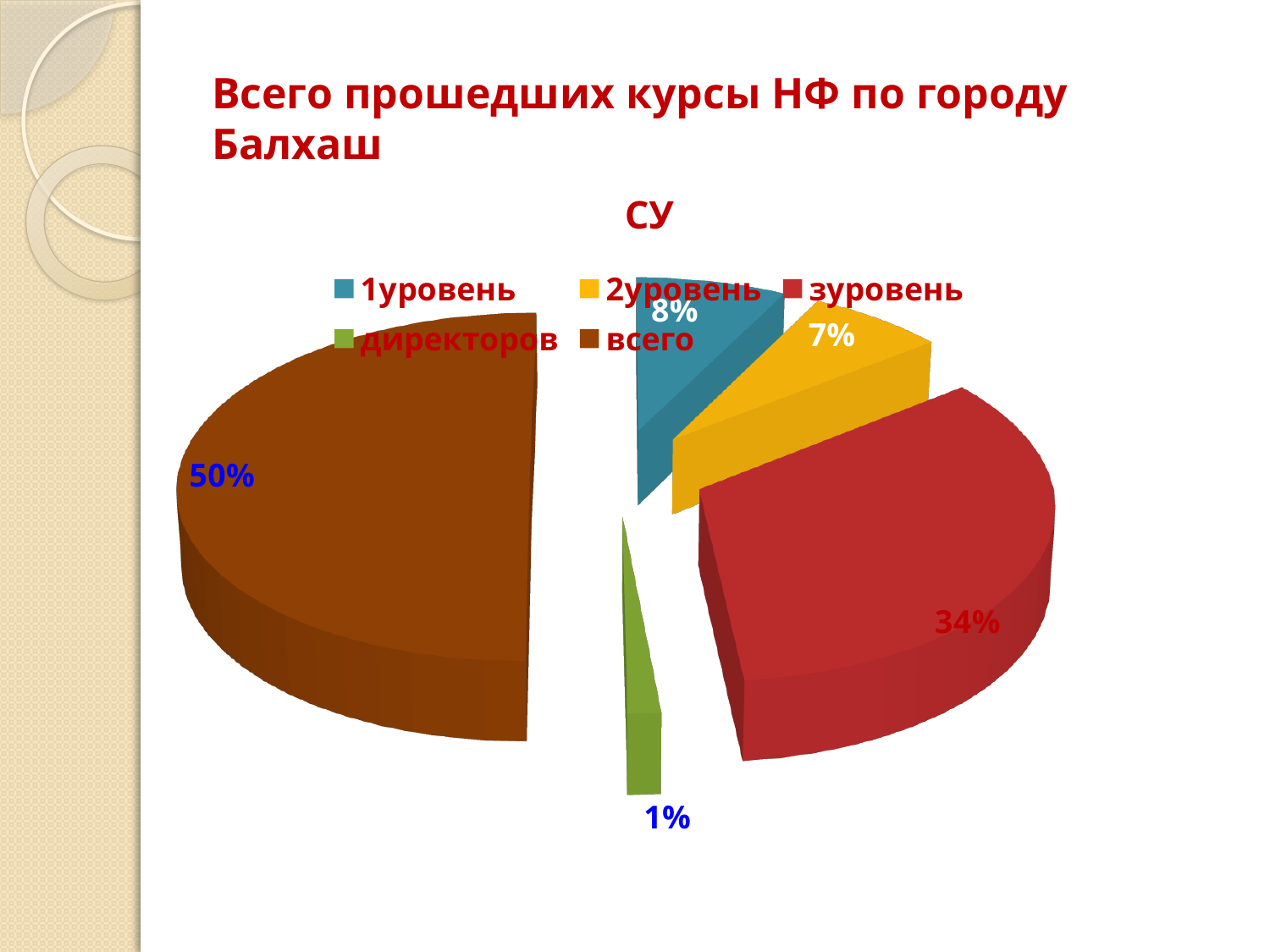
Which category has the largest slice of the pie? всего How many entries does the chart legend list? 5 What is the title of the chart? СУ What kind of chart is shown on the slide? pie chart Which category has the smallest slice of the pie? директоров What is the difference in percentage points between the 'всего' slice and the '3уровень' slice? 16% What share of the pie does the '2уровень' slice represent? 7% What share of the pie does the 'всего' slice represent? 50% What share of the pie does the '1уровень' slice represent? 8% Which slice is larger, '1уровень' or '2уровень'? 1уровень